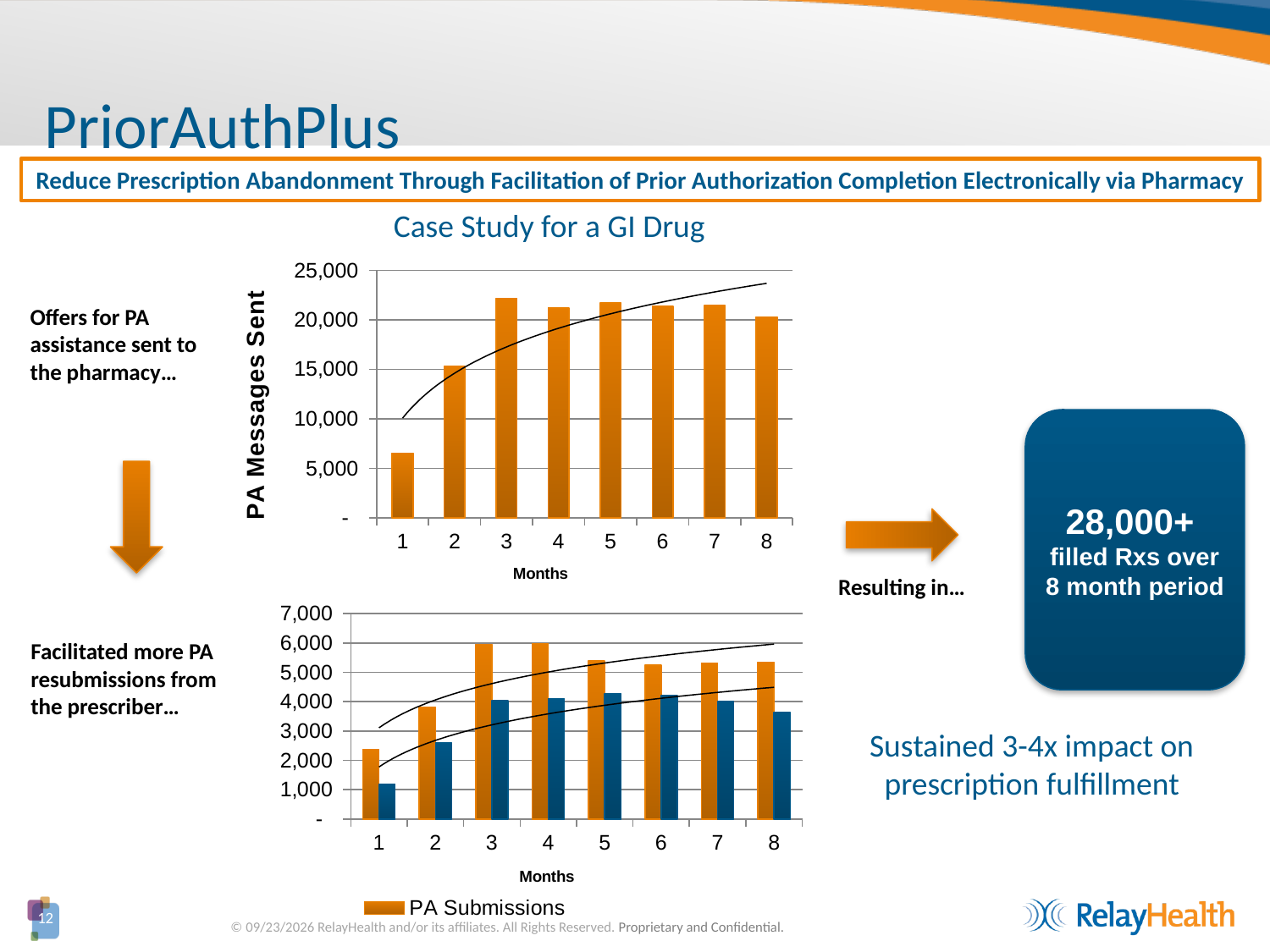
What kind of chart is the top chart (PA Messages Sent)? bar chart What is the y-axis title of the top chart? PA Messages Sent In the bottom chart, is the PA Submissions value for month 8 greater or less than 5,000? greater In the bottom chart, which series is shown in orange according to the legend? PA Submissions In the bottom chart, which month has the lowest PA Submissions value? 1 In the top chart (PA Messages Sent), does the fitted trend line rise or fall from month 1 to month 8? rise In the bottom chart, is the PA Submissions value for month 1 greater or less than 3,000? less In the top chart (PA Messages Sent), is the value for month 3 greater or less than 20,000? greater In the top chart (PA Messages Sent), how many months are plotted on the x axis? 8 In the top chart (PA Messages Sent), which month has the lowest value? 1